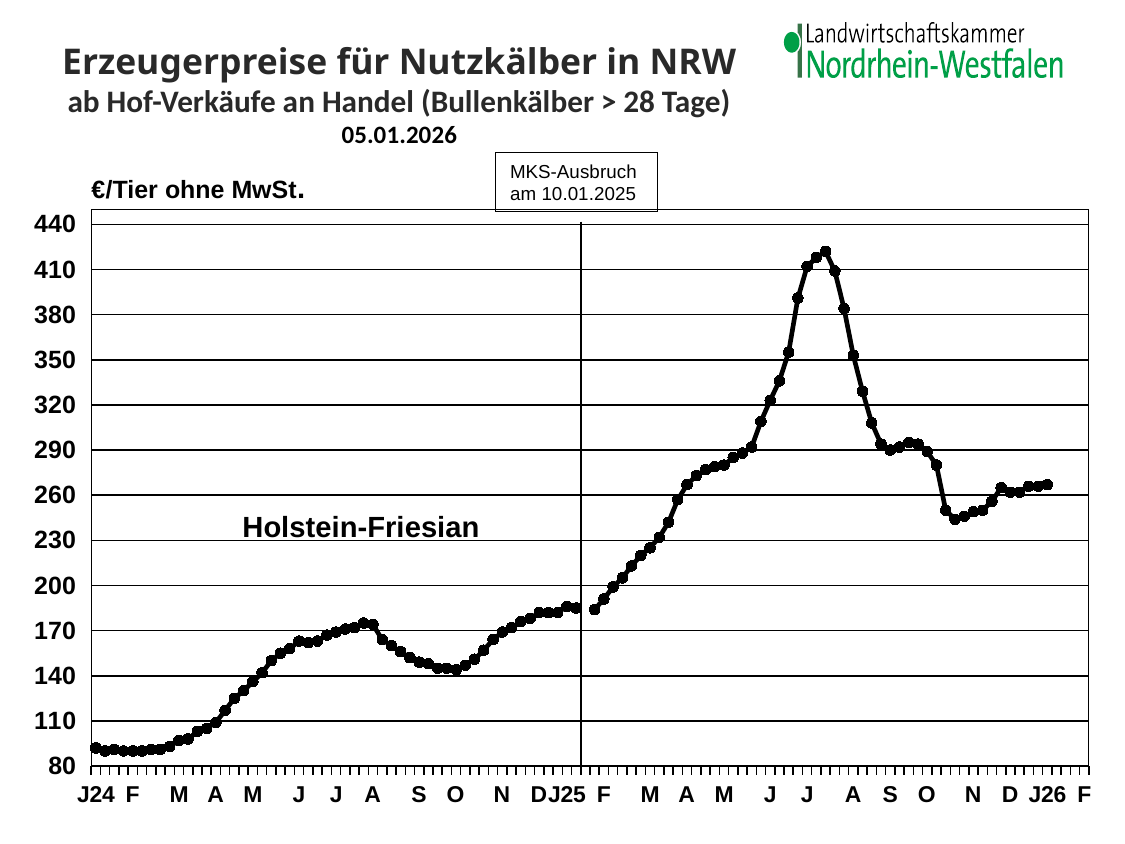
Do the values rise or fall from J24 to August 2024 (A)? rise Is the lowest value in October 2024 greater or less than 170? less Which breed is named as the plotted series on the chart? Holstein-Friesian Is the value in May 2025 (M) greater or less than 230? greater Do the values rise or fall from the August 2025 peak to October 2025 (O)? fall Is the value at J26 greater or less than 260? greater What is the title of the chart? Erzeugerpreise für Nutzkälber in NRW Which is larger, the value at J26 or the value at J24? J26 What kind of chart is shown on the slide? line chart Which is larger, the peak in August 2024 or the peak in August 2025? August 2025